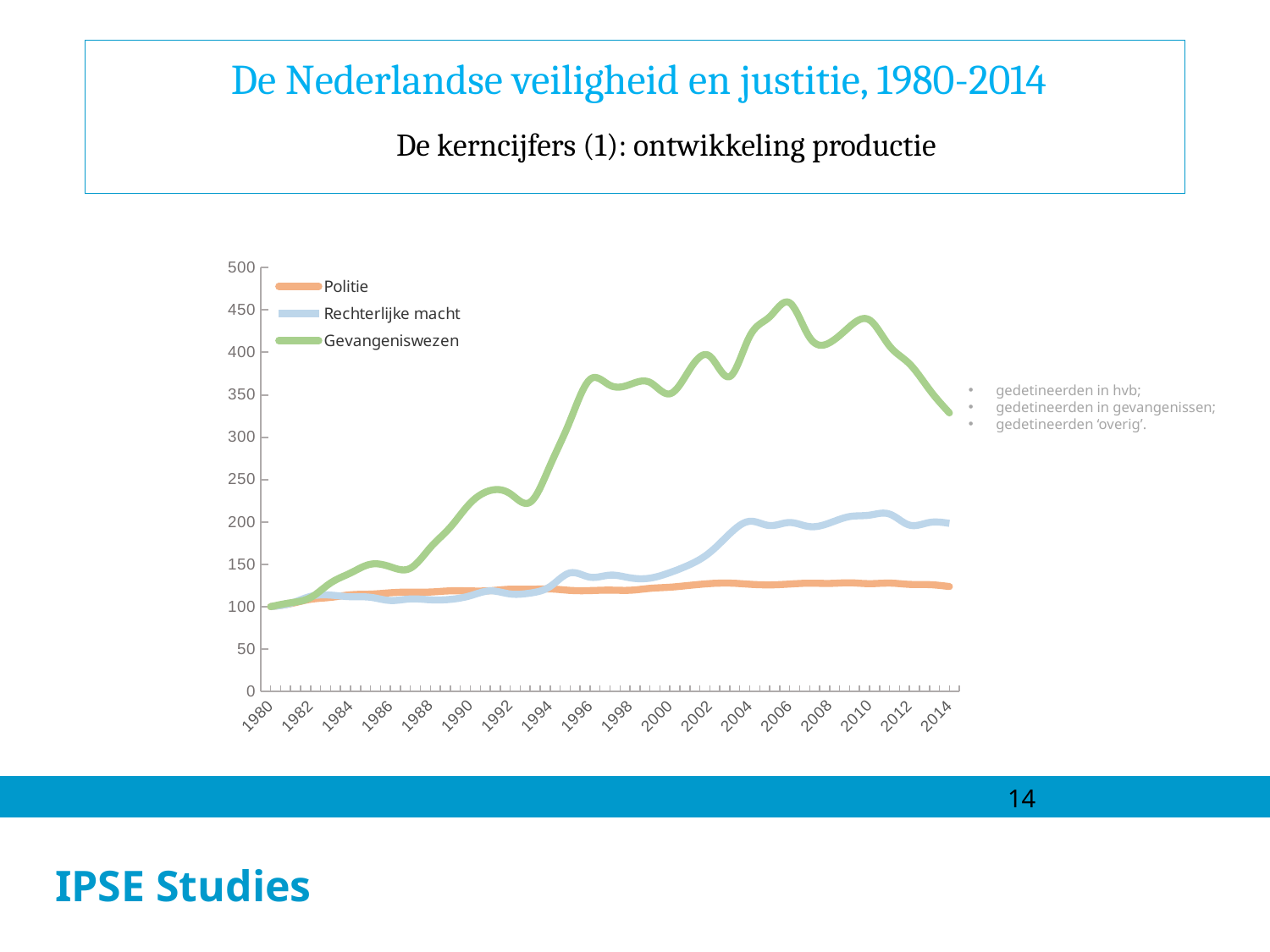
Is the value for Rechterlijke macht in 2010 greater or less than 150? greater Is the value for Politie in 2014 greater or less than 150? less Does the Rechterlijke macht line rise or fall between 1994 and 2004? rise Is the value for Gevangeniswezen in 2006 greater or less than 400? greater Which series has the highest value in 2014? Gevangeniswezen What is the value of all three series in 1980? 100 What kind of chart is shown on the slide? line chart In 2014, which is larger: Rechterlijke macht or Politie? Rechterlijke macht Which series has the lowest value in 2014? Politie How many series does the legend list? 3 Which series are listed in the legend? Politie, Rechterlijke macht, Gevangeniswezen Does the Gevangeniswezen line rise or fall between 2006 and 2014? fall